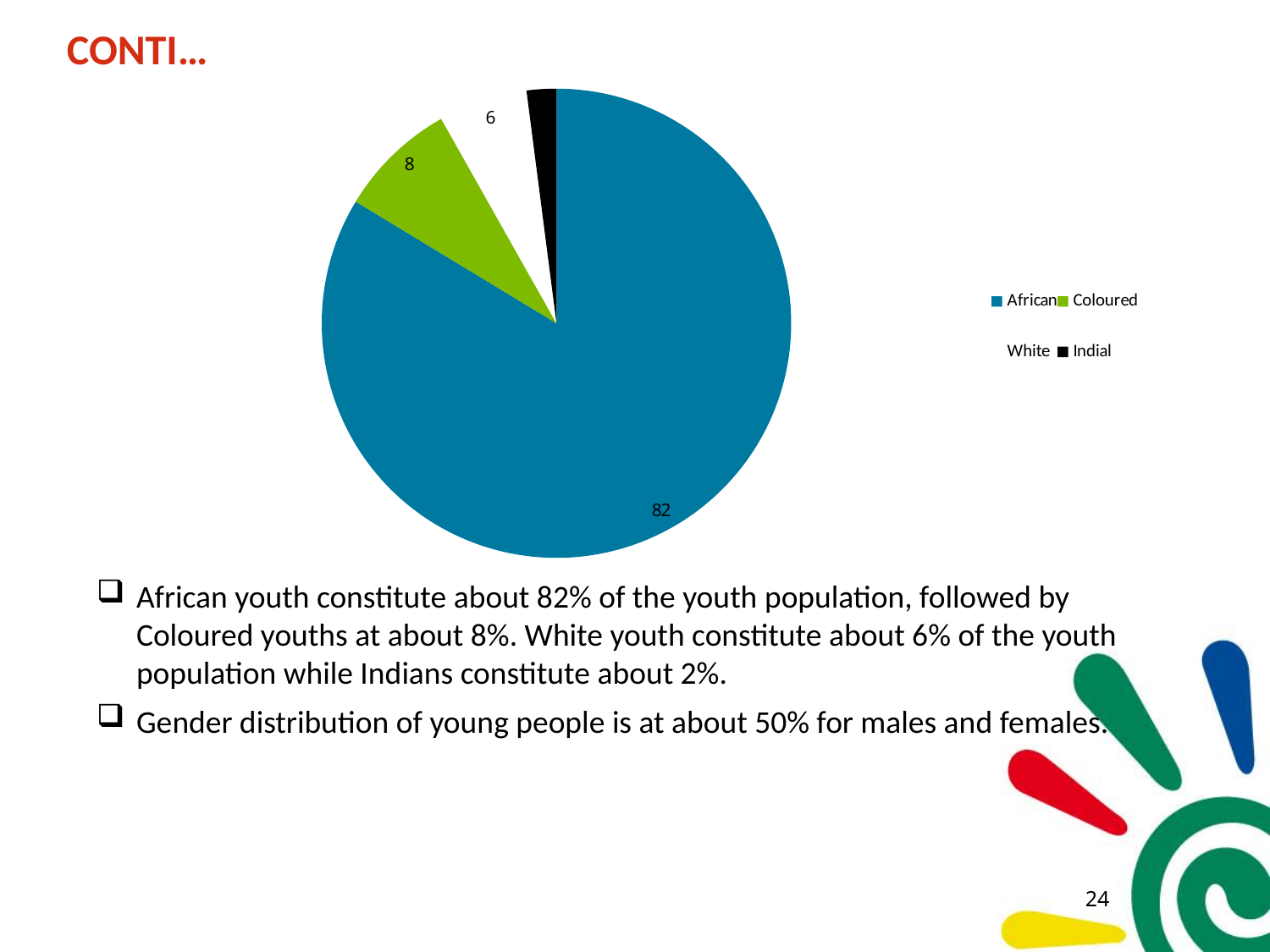
How many entries does the legend of the pie chart list? 4 Which slice is larger in the pie chart, Coloured or White? Coloured What is the difference between the African value and the Coloured value in the pie chart? 74 What colour is the African slice in the pie chart? Blue Which category has the smallest slice in the pie chart? Indial How many slices does the pie chart have? 4 What is the difference between the Coloured value and the White value in the pie chart? 2 What value is shown for the African slice of the pie chart? 82 What value is shown for the White slice of the pie chart? 6 What kind of chart is shown on the slide? Pie chart What value is shown for the Coloured slice of the pie chart? 8 Which category has the largest slice in the pie chart? African